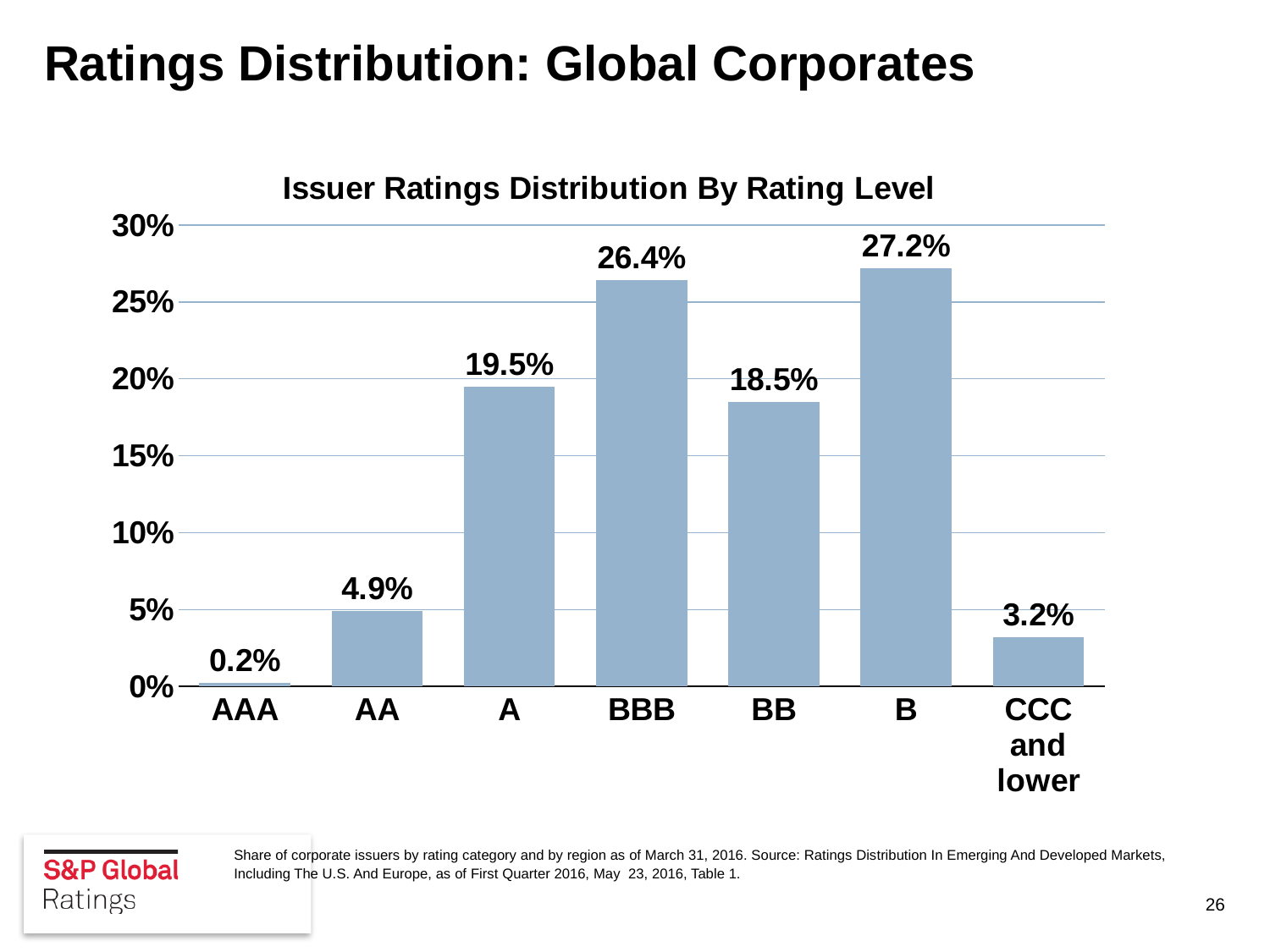
What is the value for AAA? 0.2% Which rating level has the lowest share? AAA What is the difference between the values for B and BBB? 0.8% What is the value for CCC and lower? 3.2% What is the value for BBB? 26.4% What is the title of the chart? Issuer Ratings Distribution By Rating Level Is the value for BB greater or less than 20%? less How many rating levels are shown on the x axis? 7 What kind of chart is shown on the slide? bar chart What is the difference between the values for A and BB? 1.0% Which rating level has the highest share? B Which is larger, the value for AA or the value for CCC and lower? AA